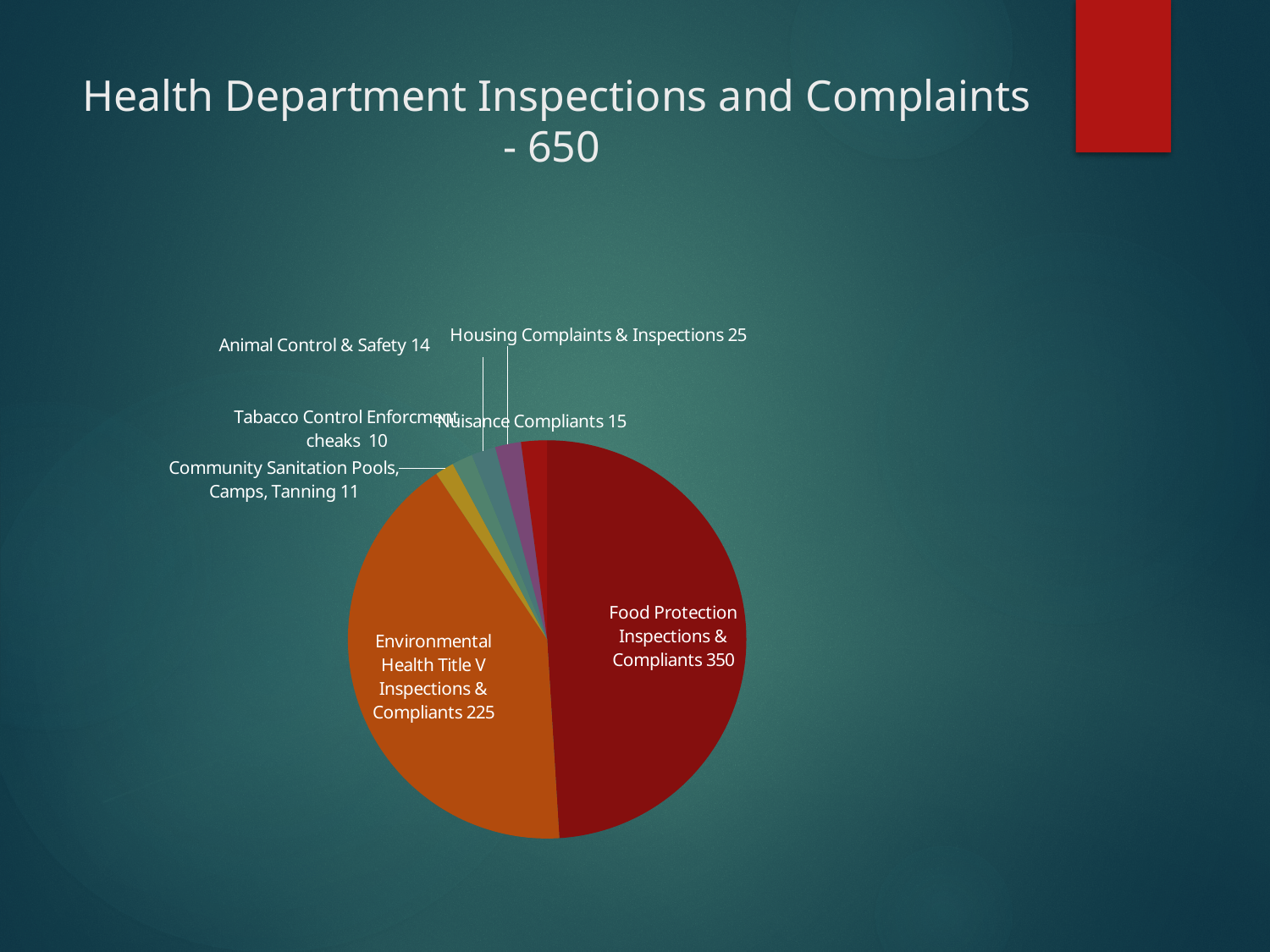
What is the difference between the values for Food Protection Inspections & Compliants and Environmental Health Title V Inspections & Compliants? 125 What is the value for Environmental Health Title V Inspections & Compliants? 225 What is the value for Animal Control & Safety? 14 How many slices does the pie chart have? 7 What is the value for Community Sanitation Pools, Camps, Tanning? 11 Which category has the largest slice of the pie? Food Protection Inspections & Compliants What kind of chart is shown on the slide? pie chart Which is larger, Housing Complaints & Inspections or Nuisance Compliants? Housing Complaints & Inspections What is the value for Food Protection Inspections & Compliants? 350 What is the title of the slide? Health Department Inspections and Complaints - 650 What is the value for Housing Complaints & Inspections? 25